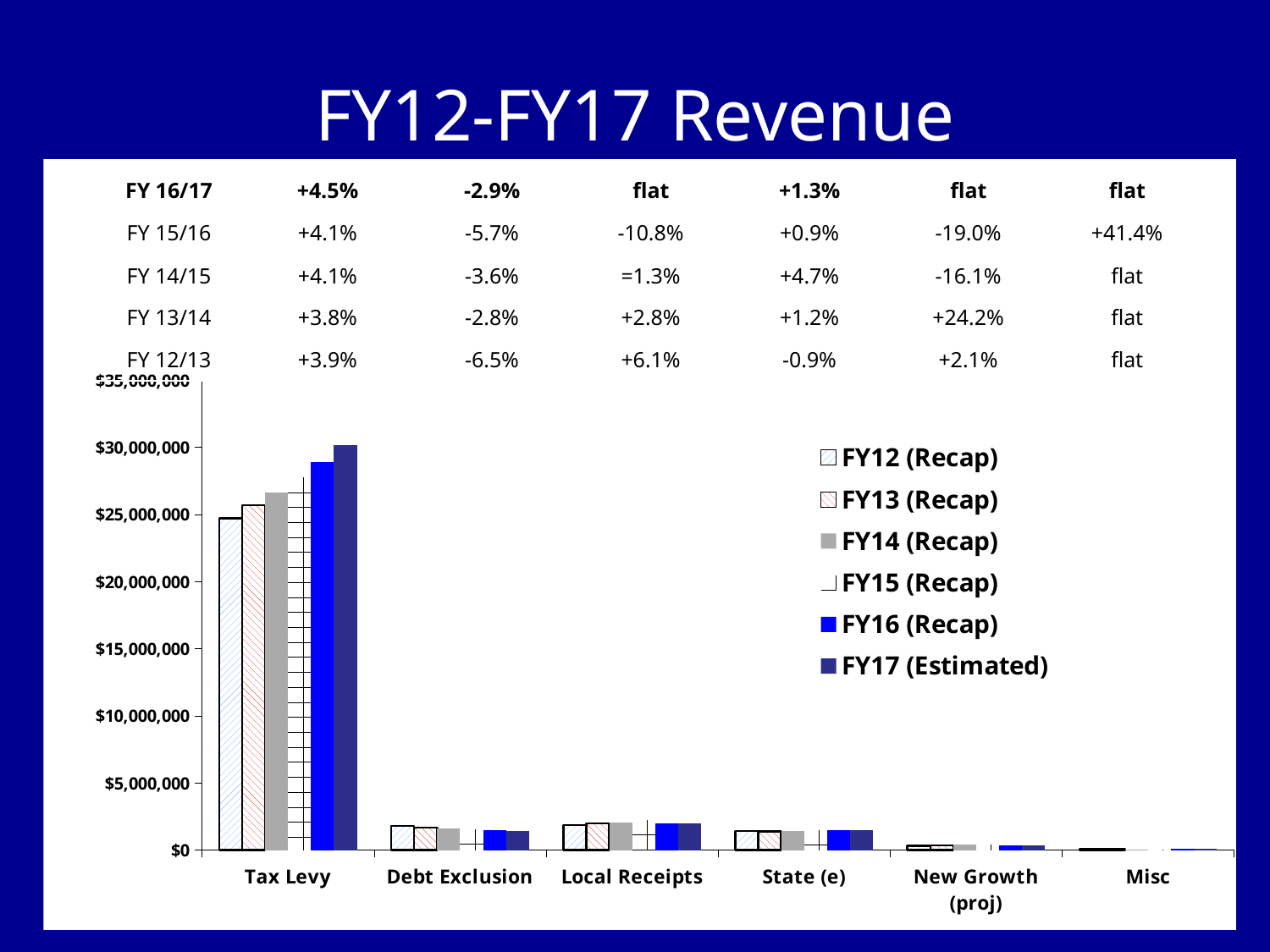
What is the title of the slide containing the chart? FY12-FY17 Revenue Which legend entry is labelled as estimated rather than recap? FY17 (Estimated) For Tax Levy, which is larger: the FY17 (Estimated) value or the FY12 (Recap) value? FY17 (Estimated) How many categories are shown on the x axis of the chart? 6 What kind of chart is shown on the slide? bar chart Do the Tax Levy values rise or fall from FY12 (Recap) to FY17 (Estimated)? rise Is the FY16 (Recap) value for Tax Levy greater or less than $30,000,000? less Which category has the highest revenue values in the chart? Tax Levy Is the FY17 (Estimated) value for Debt Exclusion greater or less than $5,000,000? less Which category has the lowest revenue values in the chart? Misc How many series does the chart's legend list? 6